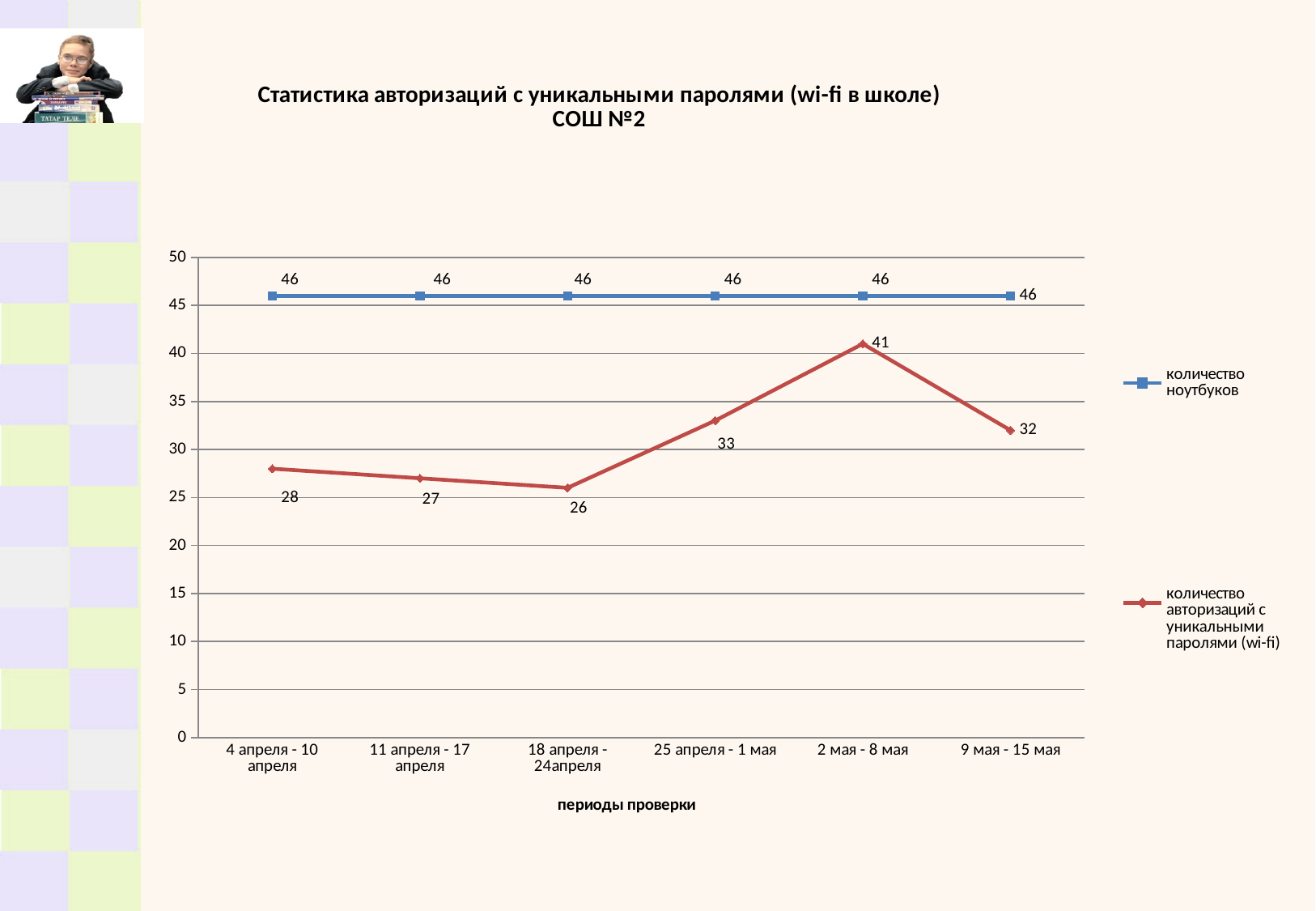
In which period is 'количество авторизаций с уникальными паролями (wi-fi)' highest? 2 мая - 8 мая Which is larger for the period '25 апреля - 1 мая': 'количество авторизаций с уникальными паролями (wi-fi)' or the value for '9 мая - 15 мая'? 25 апреля - 1 мая What is the value of 'количество авторизаций с уникальными паролями (wi-fi)' for the period '2 мая - 8 мая'? 41 Does 'количество авторизаций с уникальными паролями (wi-fi)' rise or fall from '4 апреля - 10 апреля' to '18 апреля - 24апреля'? fall How many periods are shown on the x axis? 6 What is the title of the chart? Статистика авторизаций с уникальными паролями (wi-fi в школе) СОШ №2 What is the difference between 'количество ноутбуков' and 'количество авторизаций с уникальными паролями (wi-fi)' for the period '2 мая - 8 мая'? 5 In which period is 'количество авторизаций с уникальными паролями (wi-fi)' lowest? 18 апреля - 24апреля What is the value of 'количество авторизаций с уникальными паролями (wi-fi)' for the period '18 апреля - 24апреля'? 26 What kind of chart is shown on the slide? line chart What is the value of 'количество ноутбуков' for the period '9 мая - 15 мая'? 46 How many series does the legend list? 2